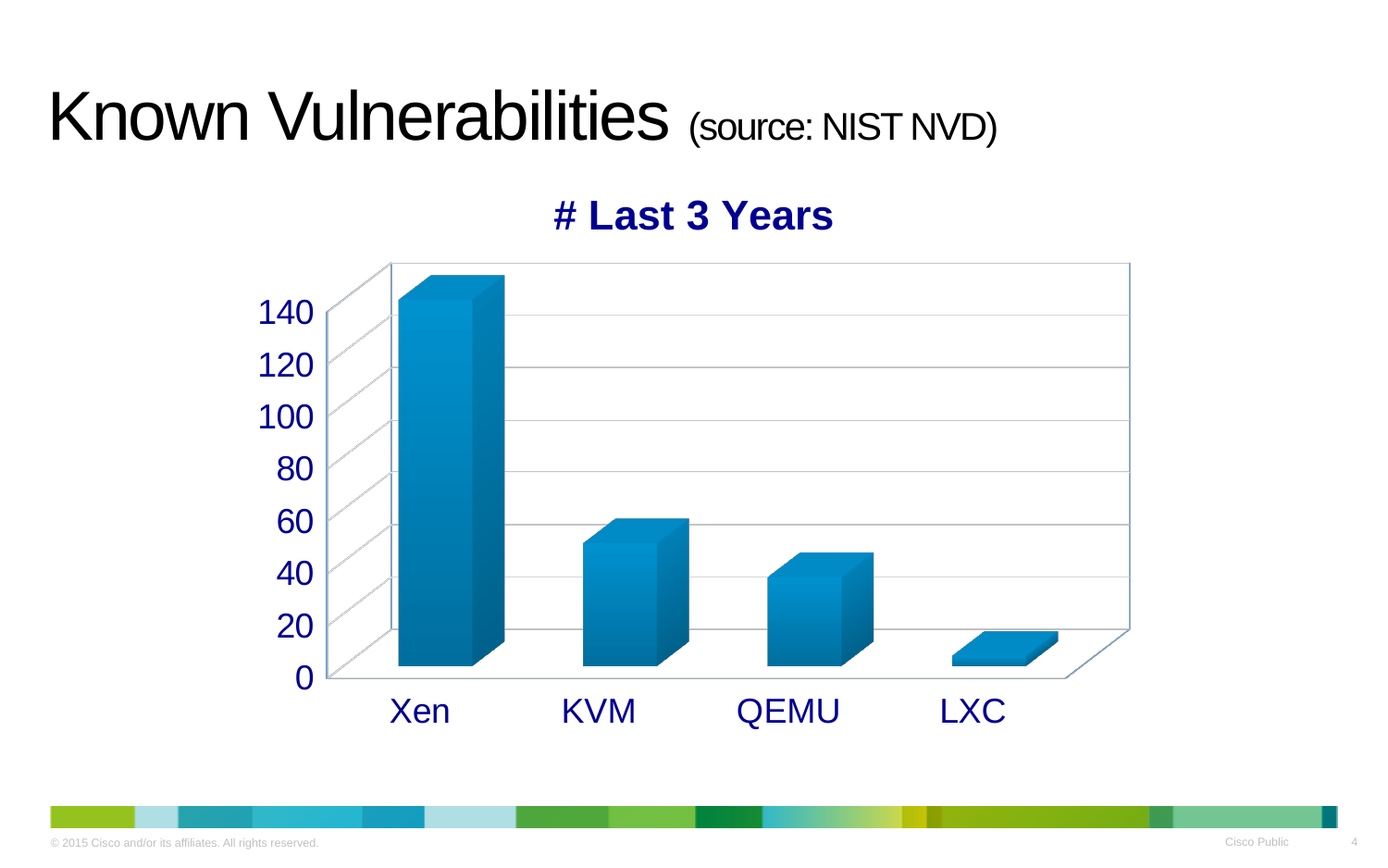
Is the value for Xen greater or less than 100? greater Which has more known vulnerabilities, KVM or QEMU? KVM Which category has the highest number of known vulnerabilities in the last 3 years? Xen Is the value for LXC greater or less than 20? less Which category has the lowest number of known vulnerabilities in the last 3 years? LXC Is the value for KVM greater or less than 60? less How many categories are shown on the x axis of the chart? 4 What kind of chart is shown on the slide? bar chart What is the title of the chart? # Last 3 Years Which has more known vulnerabilities, QEMU or LXC? QEMU